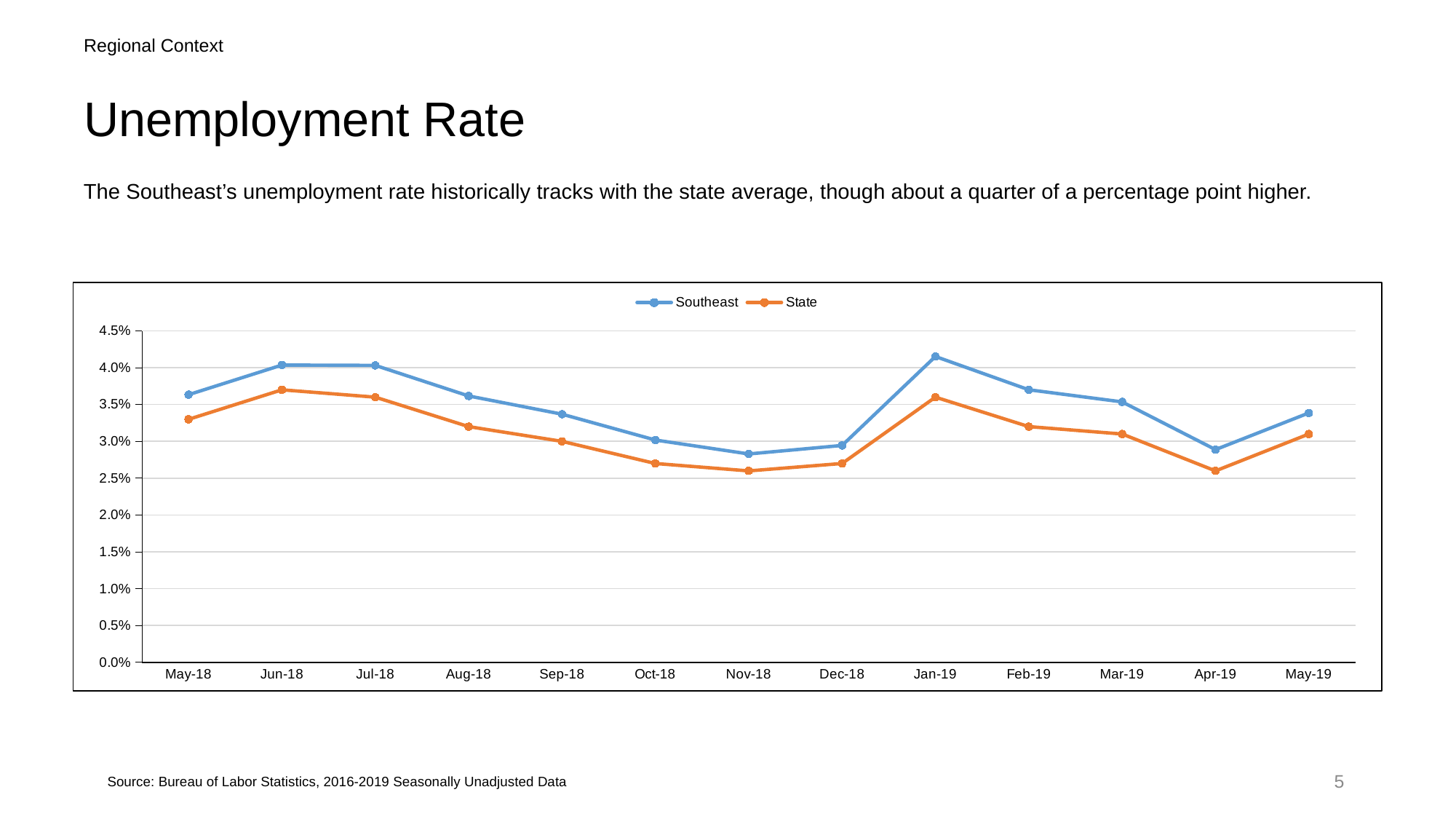
How many series does the chart legend list? 2 How many months are plotted along the x axis of the chart? 13 Which two series are listed in the chart legend? Southeast and State What kind of chart is shown on the slide? line chart In which month does the Southeast series reach its lowest value? Nov-18 In Jan-19, which series has the higher value, Southeast or State? Southeast What is the title of the slide containing the chart? Unemployment Rate In which month does the State series reach its highest value? Jun-18 Is the State value for Nov-18 greater or less than 3.0%? less Do the Southeast values rise or fall from Jan-19 to Apr-19? fall In which month does the Southeast series reach its highest value? Jan-19 Is the Southeast value for Jan-19 greater or less than 4.0%? greater